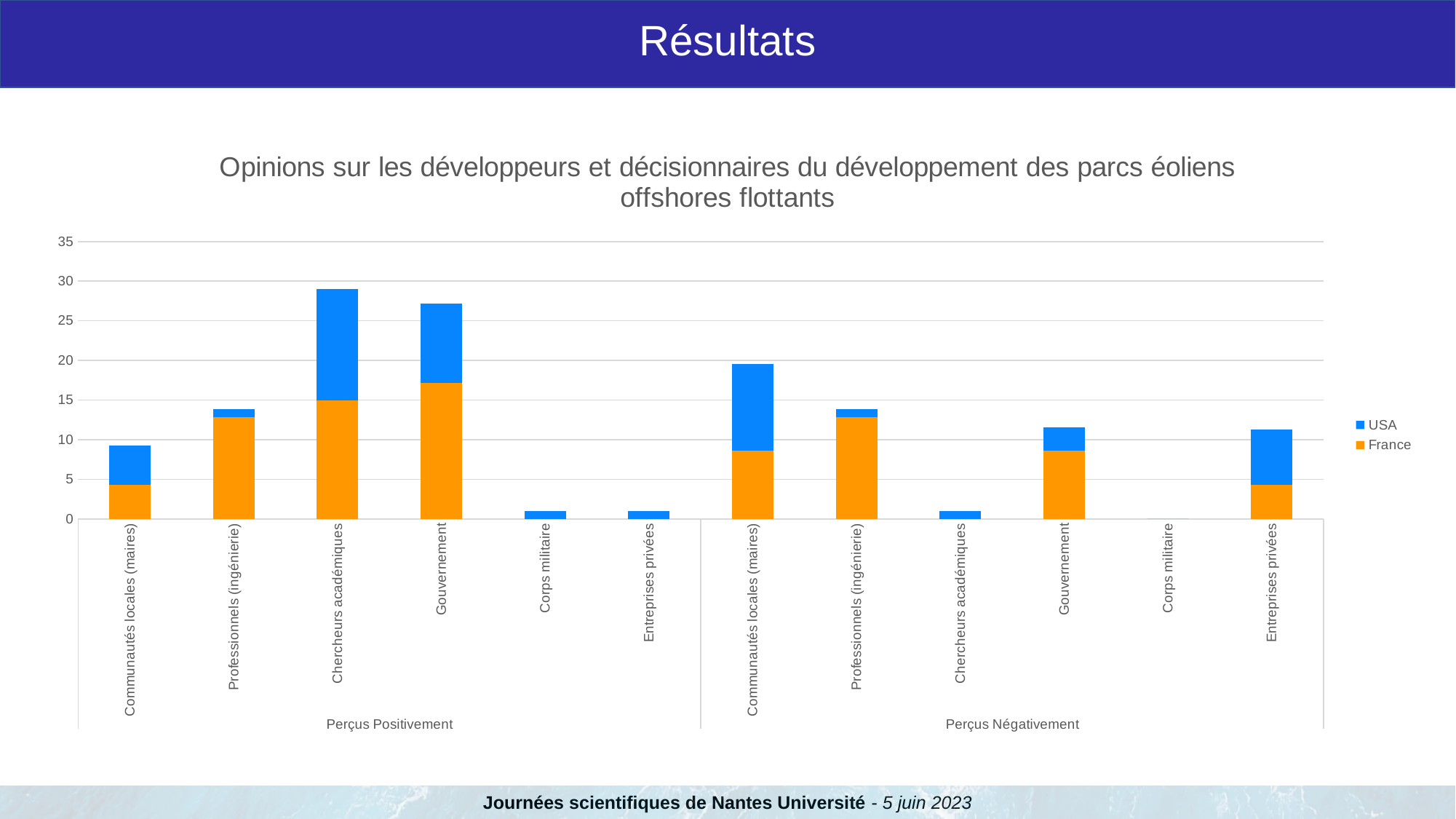
What kind of chart is shown on the slide? stacked bar chart Which category in the 'Perçus Négativement' group has no visible bar at all? Corps militaire Which series are listed in the legend? USA and France Is the total stacked value for Communautés locales (maires) in the 'Perçus Négativement' group greater or less than 15? greater How many bars are plotted in the 'Perçus Positivement' group? 6 How many series does the legend list? 2 Is the total stacked value for Gouvernement in the 'Perçus Positivement' group greater or less than 25? greater Which is larger: the stacked bar for Communautés locales (maires) in 'Perçus Positivement' or in 'Perçus Négativement'? Perçus Négativement Which category has the tallest stacked bar in the whole chart? Chercheurs académiques (Perçus Positivement) What colour represents France in the chart? orange Which is larger: the stacked bar for Gouvernement in 'Perçus Positivement' or in 'Perçus Négativement'? Perçus Positivement Is the total stacked value for Professionnels (ingénierie) in the 'Perçus Positivement' group greater or less than 15? less